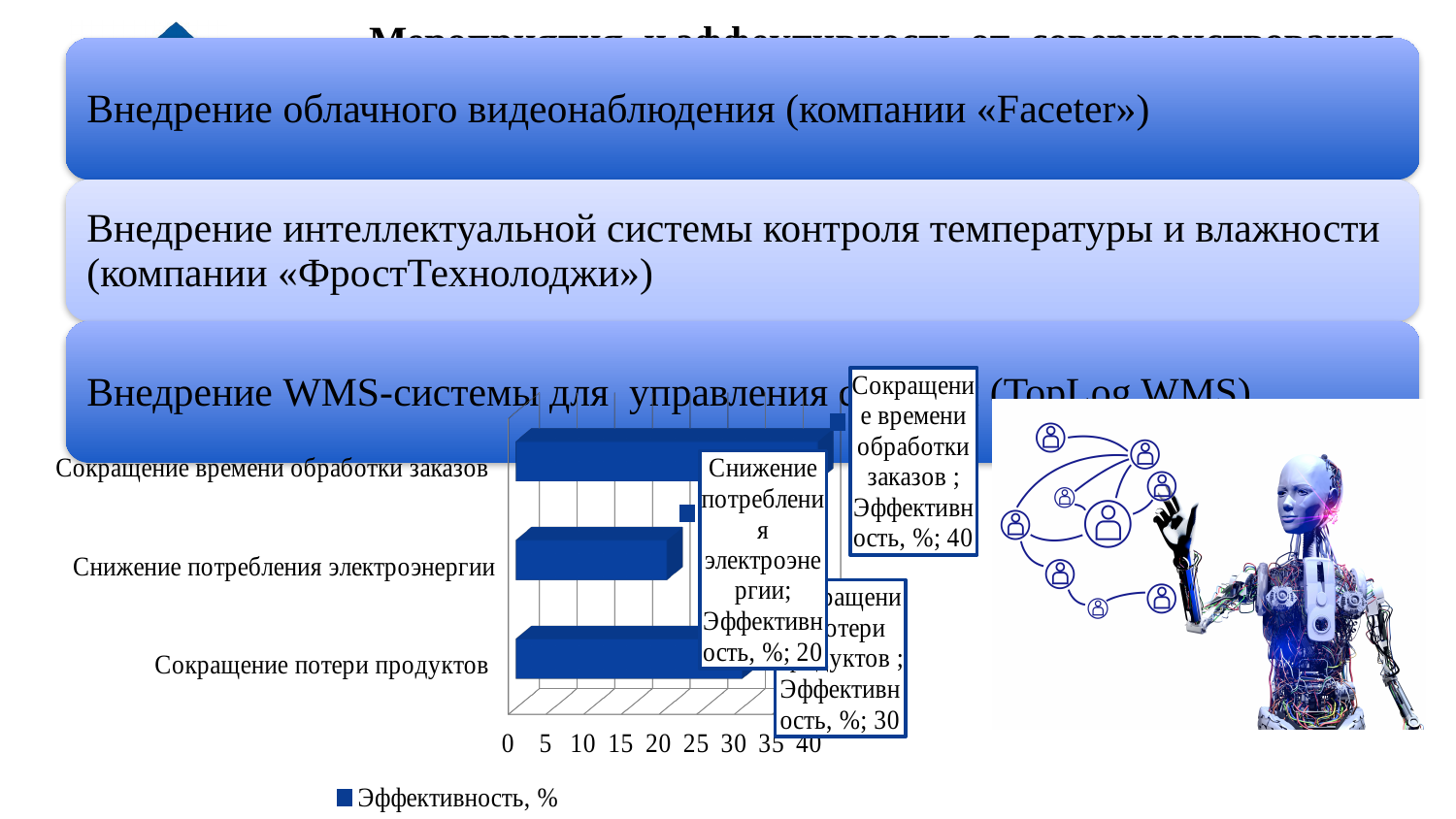
What is the value for «Снижение потребления электроэнергии»? 20 What kind of chart is shown on the slide? bar chart Which category has the highest value? Сокращение времени обработки заказов Which category has the lowest value? Снижение потребления электроэнергии Is the value for «Сокращение потери продуктов» greater or less than 25? greater What is the difference between the values for «Сокращение времени обработки заказов» and «Снижение потребления электроэнергии»? 20 What is the difference between the values for «Сокращение потери продуктов» and «Снижение потребления электроэнергии»? 10 Which is larger: the value for «Сокращение потери продуктов» or for «Снижение потребления электроэнергии»? Сокращение потери продуктов What is the value for «Сокращение времени обработки заказов»? 40 What is the value for «Сокращение потери продуктов»? 30 How many series does the legend list? 1 How many categories are shown in the chart? 3